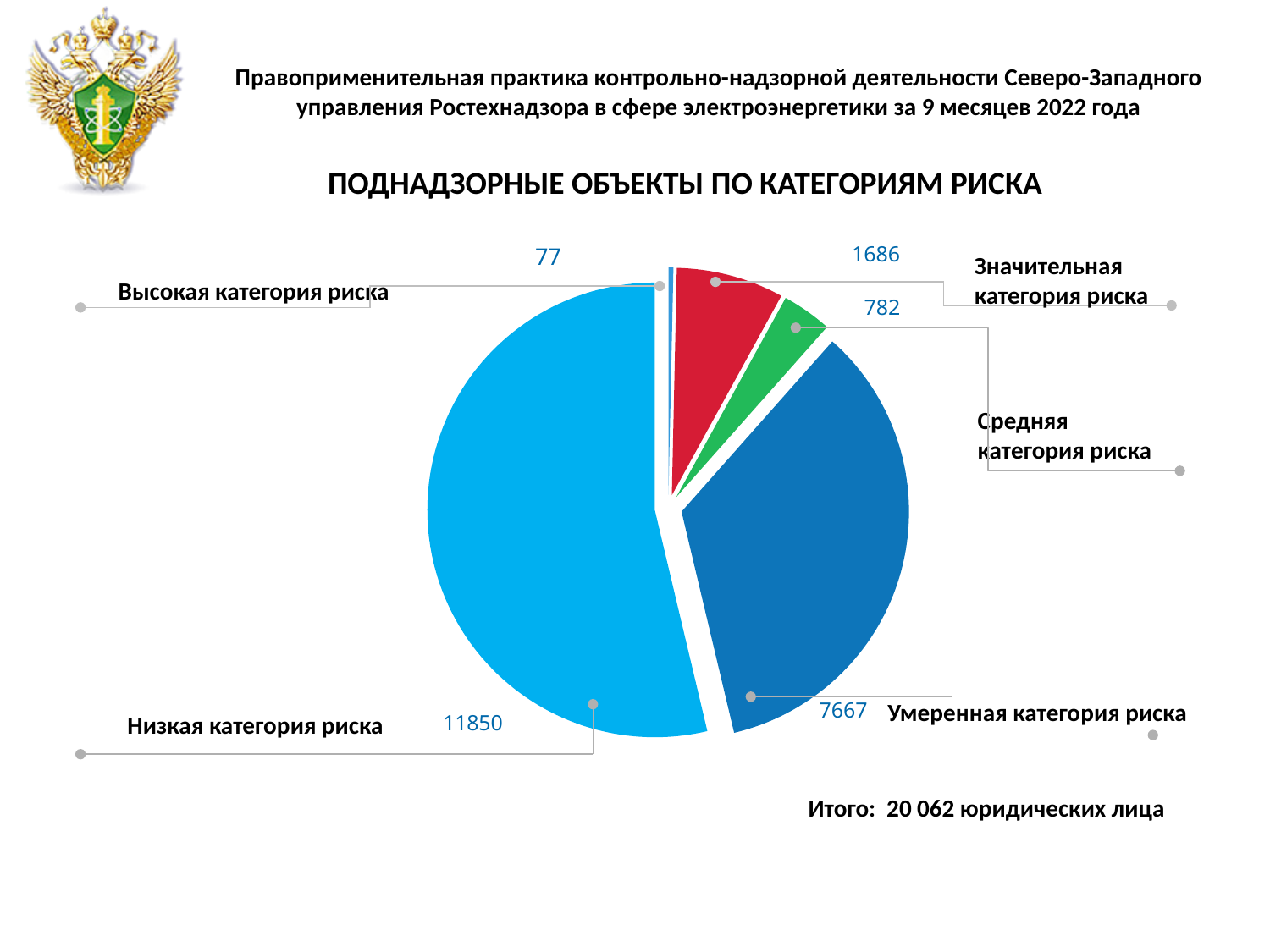
How many categories does the pie chart show? 5 Which category has the smallest slice of the pie? Высокая категория риска What is the value for Умеренная категория риска? 7667 What is the value for Высокая категория риска? 77 Which category has the largest slice of the pie? Низкая категория риска Which is larger: the value for Значительная категория риска or Средняя категория риска? Значительная категория риска What type of chart is shown on the slide? Pie chart What is the value for Средняя категория риска? 782 What is the value for Низкая категория риска? 11850 What is the value for Значительная категория риска? 1686 What is the title of the chart? ПОДНАДЗОРНЫЕ ОБЪЕКТЫ ПО КАТЕГОРИЯМ РИСКА What is the difference between the values for Низкая категория риска and Умеренная категория риска? 4183